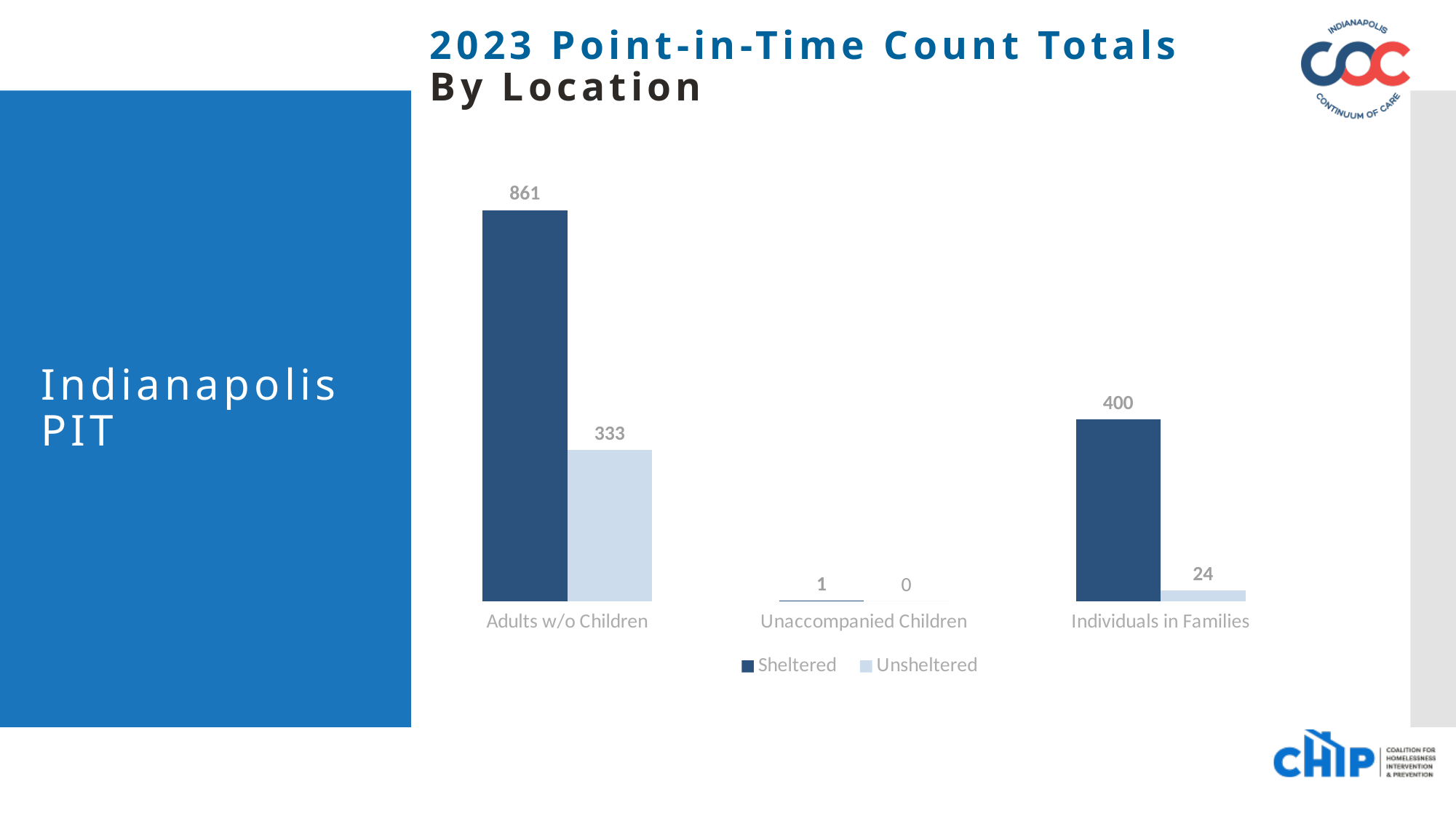
Which category has the lowest Unsheltered value? Unaccompanied Children What is the Sheltered value for Adults w/o Children? 861 What is the Sheltered value for Individuals in Families? 400 How many categories are shown on the x axis? 3 What kind of chart is shown on the slide? Bar chart What is the difference between the Sheltered and Unsheltered values for Adults w/o Children? 528 Which is larger: the Sheltered value for Individuals in Families or the Unsheltered value for Adults w/o Children? Sheltered value for Individuals in Families Which category has the highest Sheltered value? Adults w/o Children How many series does the legend list? 2 What is the Unsheltered value for Unaccompanied Children? 0 What is the Unsheltered value for Individuals in Families? 24 What is the Unsheltered value for Adults w/o Children? 333